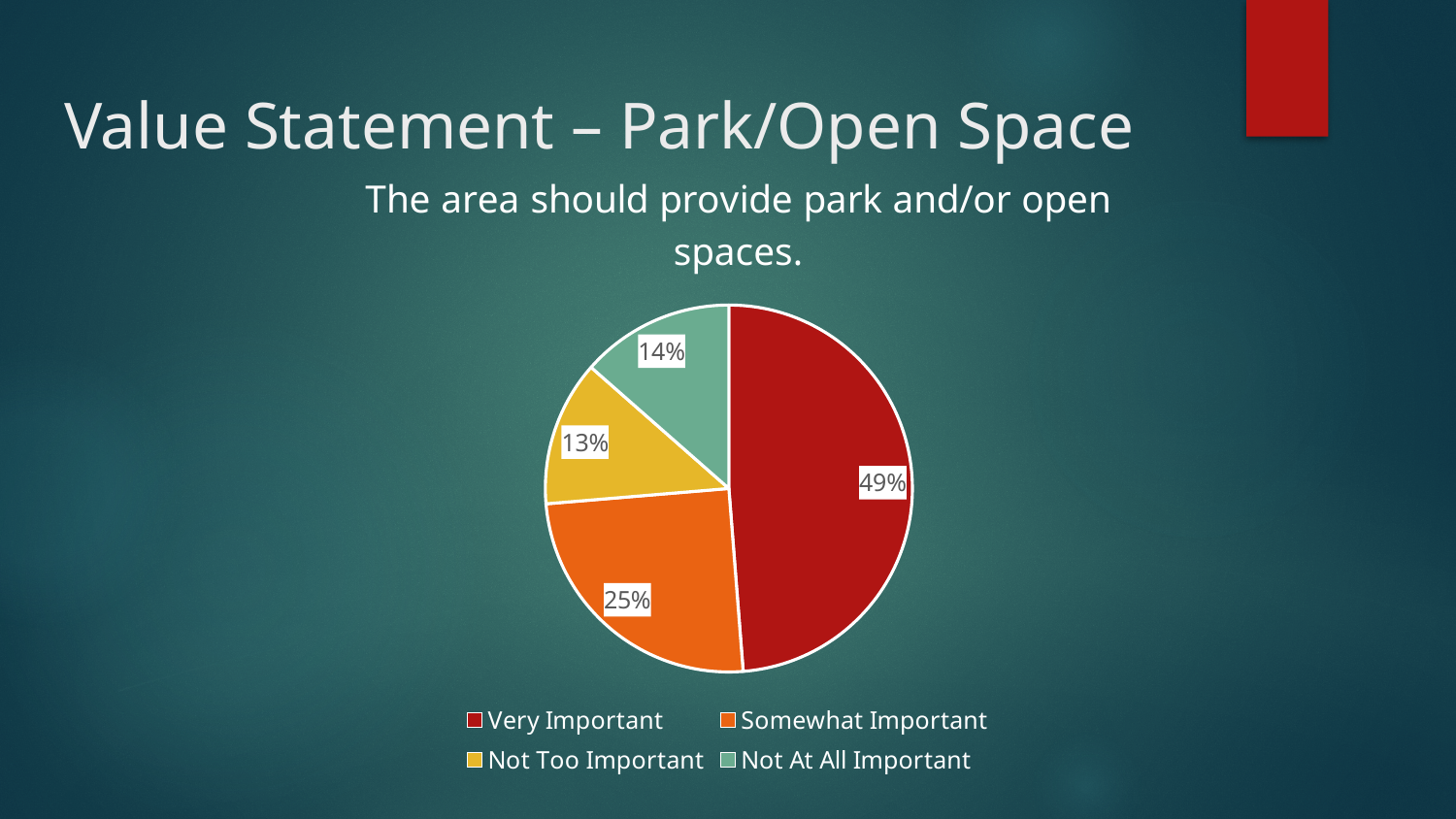
What share of the pie is labelled Not At All Important? 14% Which category has the smallest slice of the pie? Not Too Important Which slice is larger, Somewhat Important or Not At All Important? Somewhat Important What share of the pie is labelled Very Important? 49% What share of the pie is labelled Somewhat Important? 25% How many entries does the legend list? 4 Which category has the largest slice of the pie? Very Important What is the title of the chart? The area should provide park and/or open spaces. What kind of chart is shown on the slide? Pie chart How many slices does the pie chart have? 4 What is the difference in percentage points between the Very Important and Somewhat Important slices? 24